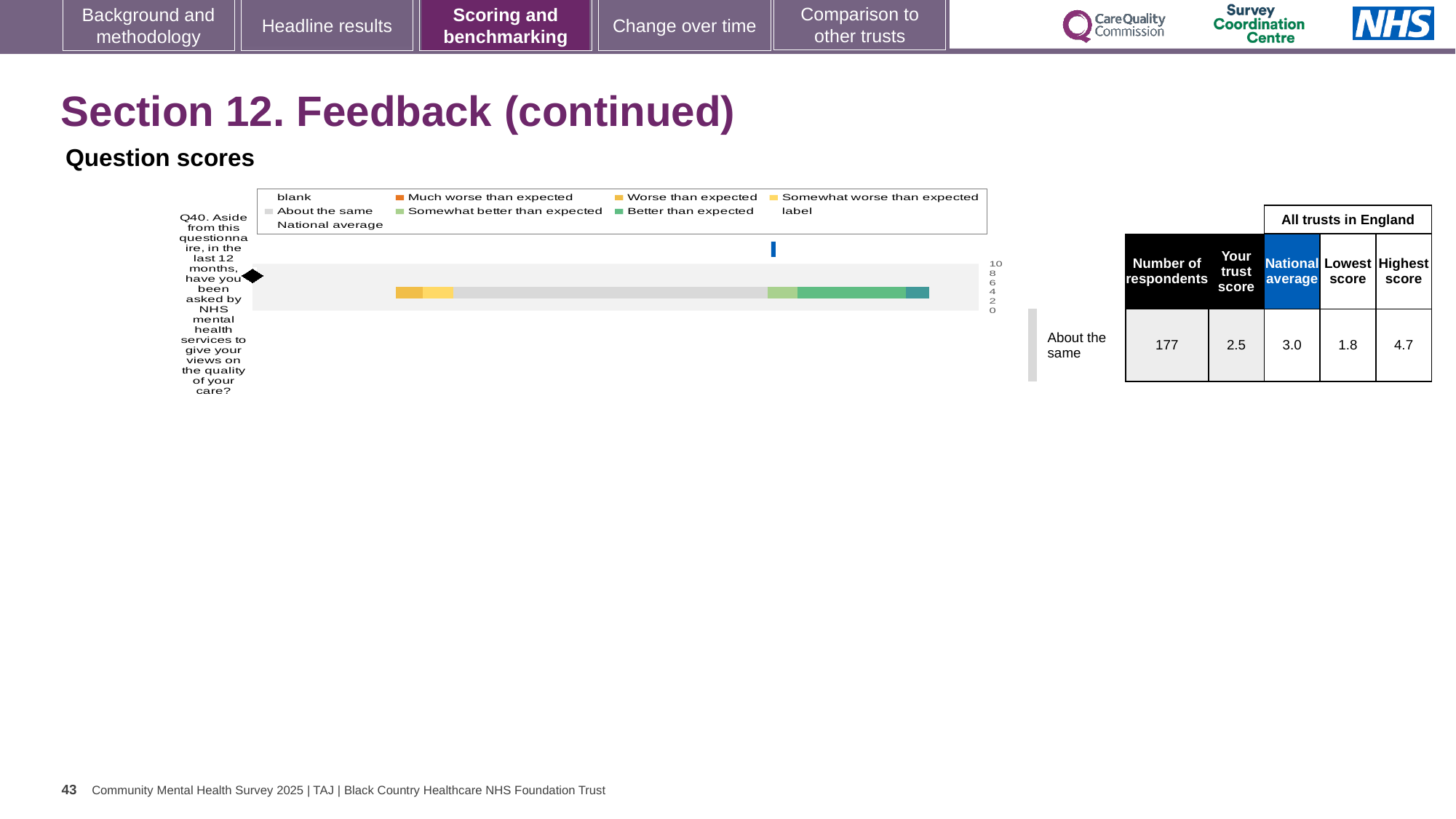
What is the national average score for Q40? 3.0 How many respondents answered Q40? 177 What is the lowest score among all trusts in England for Q40? 1.8 Which question number is plotted in the Question scores chart? Q40 For Q40, how much lower is the trust's score than the national average? 0.5 For Q40, which is larger: the trust's score or the national average? National average What kind of chart is used to show the Q40 question score? bar chart Which benchmark category is the trust's Q40 score placed in? About the same How many questions are plotted in the Question scores chart? 1 For Q40, what is the difference between the highest and lowest scores among all trusts in England? 2.9 What is the highest score among all trusts in England for Q40? 4.7 What is the trust's score for Q40? 2.5